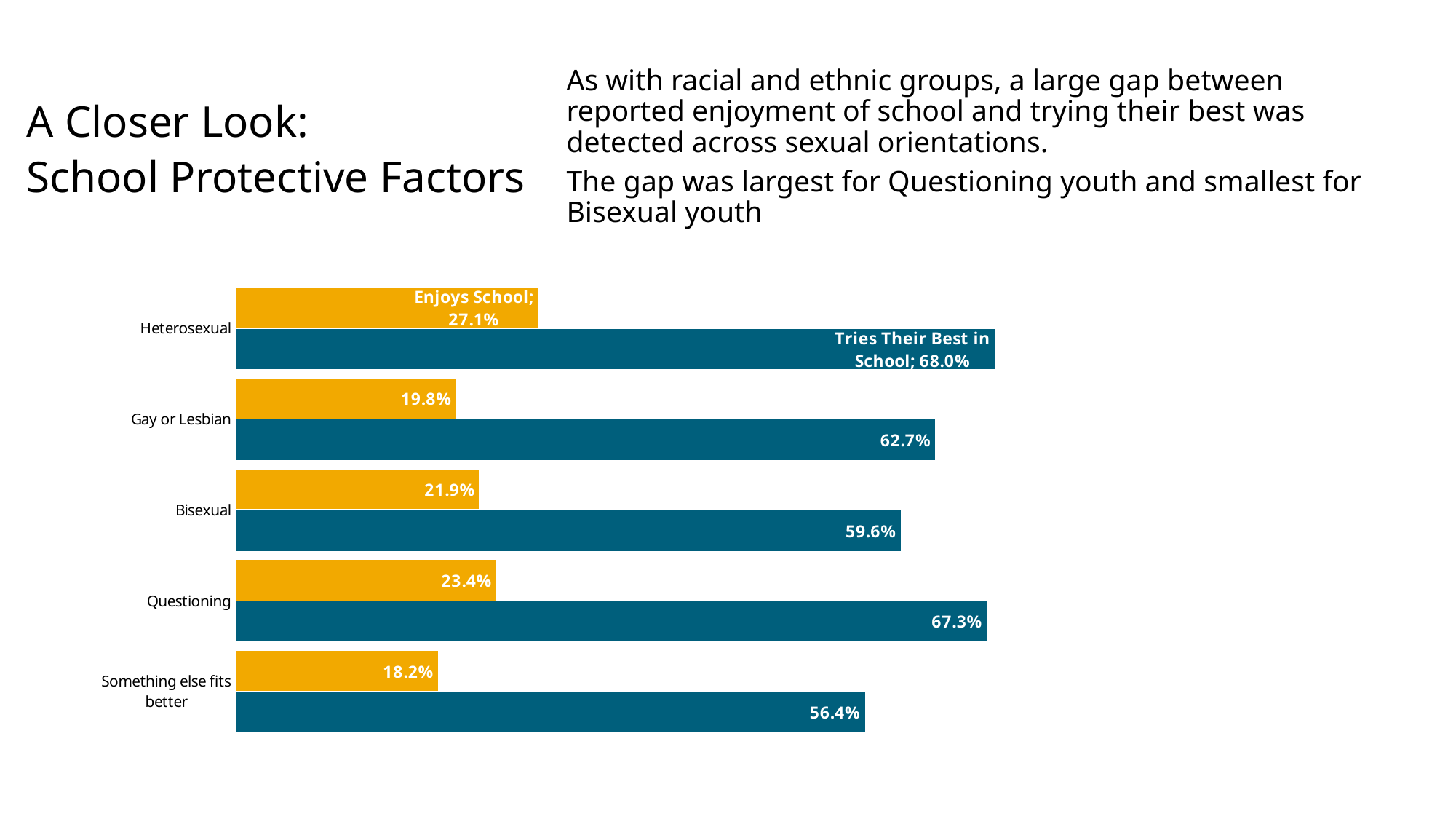
How many data series does the chart show? 2 What colour are the Enjoys School bars? Orange/yellow Which category has the highest value for Tries Their Best in School? Heterosexual What kind of chart is shown on the slide? Bar chart Which category has the lowest value for Enjoys School? Something else fits better What is the value for Enjoys School for Something else fits better? 18.2% Which is larger: the Enjoys School value for Questioning youth or for Gay or Lesbian youth? Questioning What is the value for Tries Their Best in School for Gay or Lesbian youth? 62.7% How many sexual orientation categories are shown in the chart? 5 What is the value for Tries Their Best in School for Questioning youth? 67.3% What is the difference between Tries Their Best in School and Enjoys School for Bisexual youth? 37.7% What is the value for Enjoys School for Heterosexual youth? 27.1%